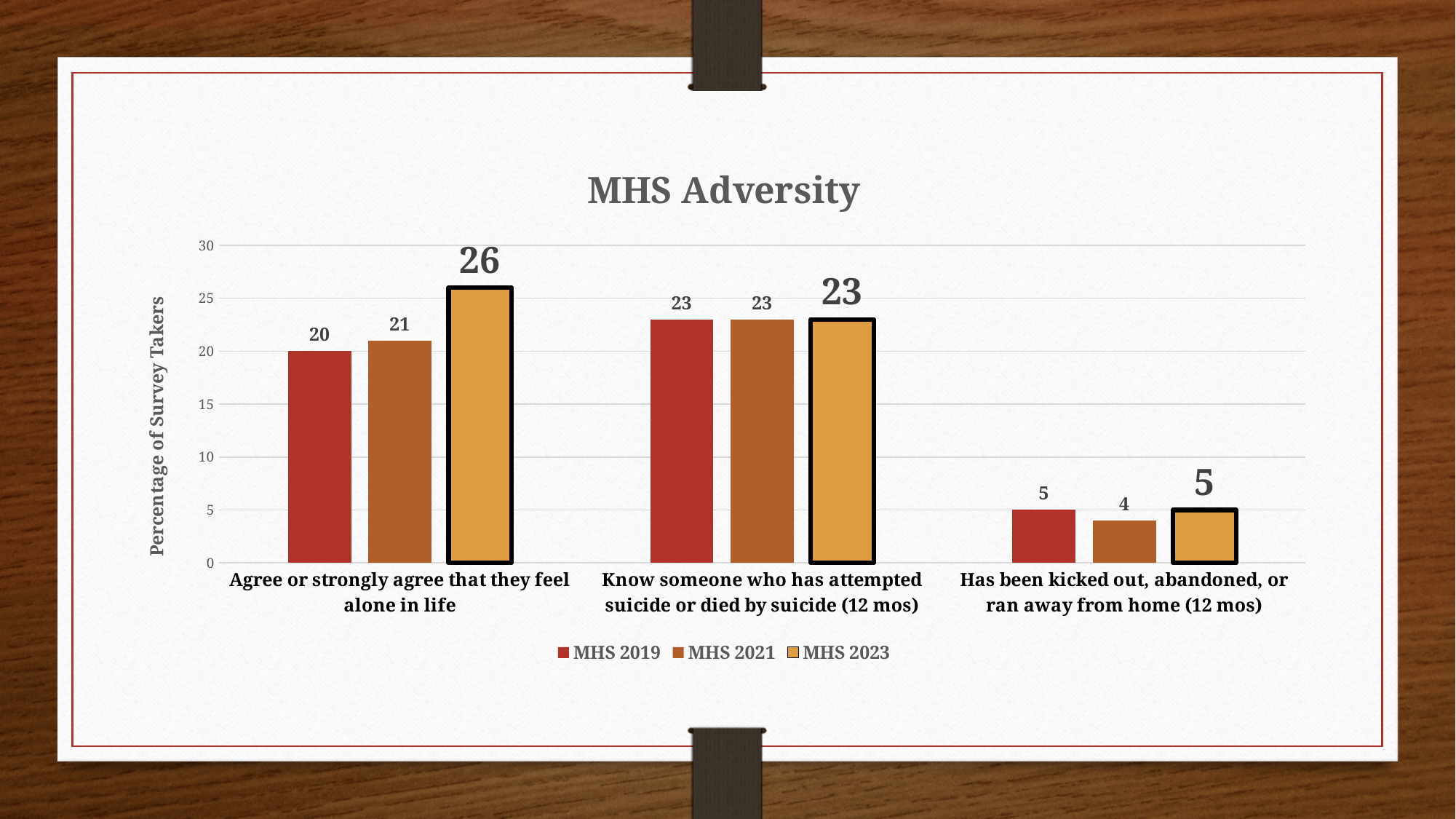
Which category has the lowest MHS 2023 value? Has been kicked out, abandoned, or ran away from home (12 mos) What is the title of the chart? MHS Adversity For 'Agree or strongly agree that they feel alone in life', which is larger: the MHS 2021 value or the MHS 2023 value? MHS 2023 Which category has the highest MHS 2023 value? Agree or strongly agree that they feel alone in life What is the MHS 2019 value for 'Know someone who has attempted suicide or died by suicide (12 mos)'? 23 What kind of chart is shown on the slide? Bar chart What is the MHS 2023 value for 'Agree or strongly agree that they feel alone in life'? 26 What is the MHS 2021 value for 'Has been kicked out, abandoned, or ran away from home (12 mos)'? 4 How many series does the legend list? 3 How many categories are shown on the x axis? 3 What is the difference between the MHS 2023 and MHS 2019 values for 'Agree or strongly agree that they feel alone in life'? 6 What is the label on the vertical axis? Percentage of Survey Takers